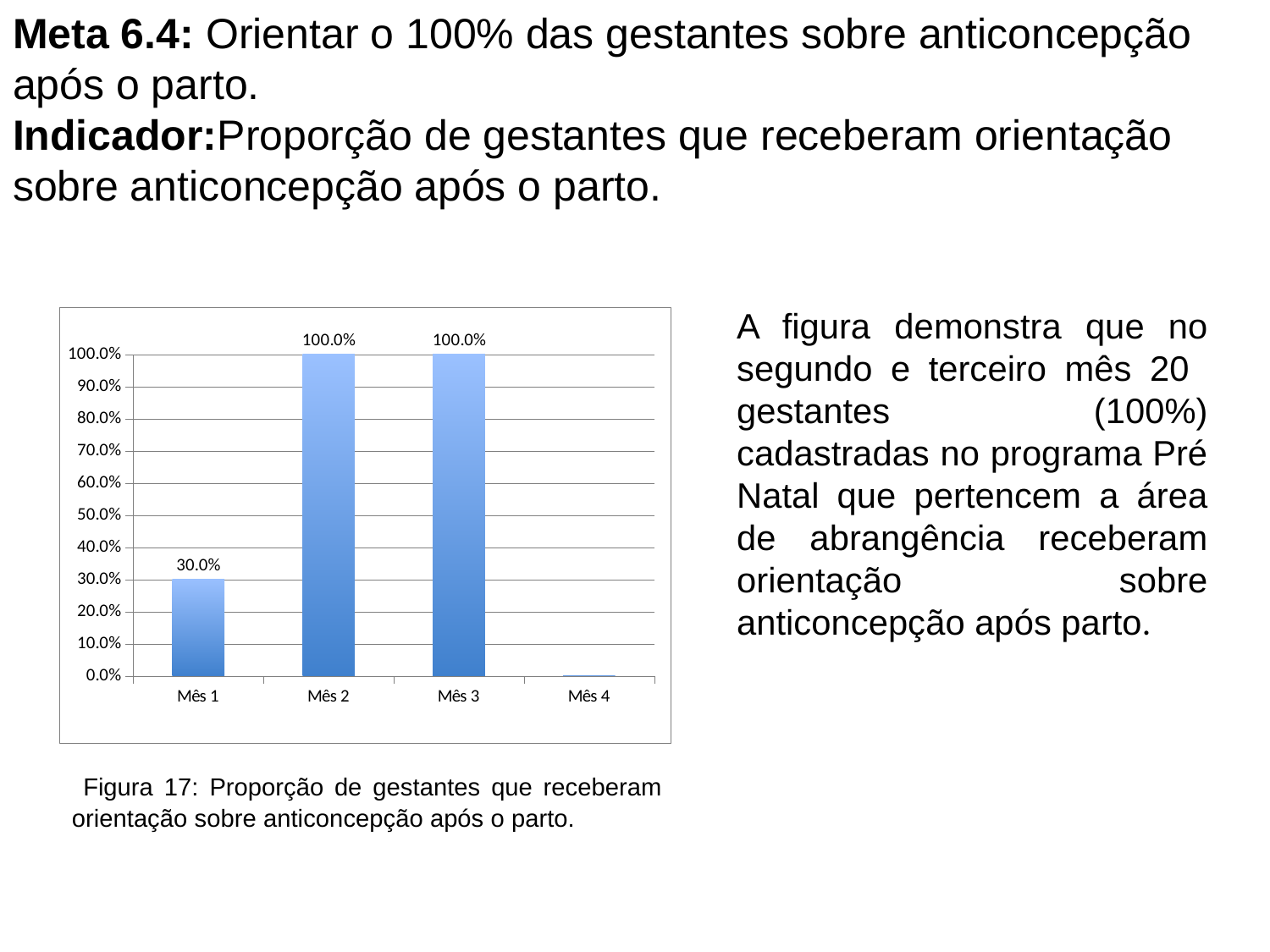
Which is larger, the value for Mês 1 or the value for Mês 2? Mês 2 What is the value for Mês 1? 30.0% What figure number is given in the caption below the chart? Figura 17 Is the value for Mês 1 greater or less than 50.0%? less What is the difference between the values for Mês 2 and Mês 1? 70.0% What kind of chart is shown on the slide? bar chart How many months are shown on the x axis? 4 What is the value for Mês 3? 100.0% Is the value for Mês 4 greater or less than 10.0%? less Does the value rise or fall from Mês 3 to Mês 4? fall Which month has the lowest value? Mês 4 What is the value for Mês 2? 100.0%